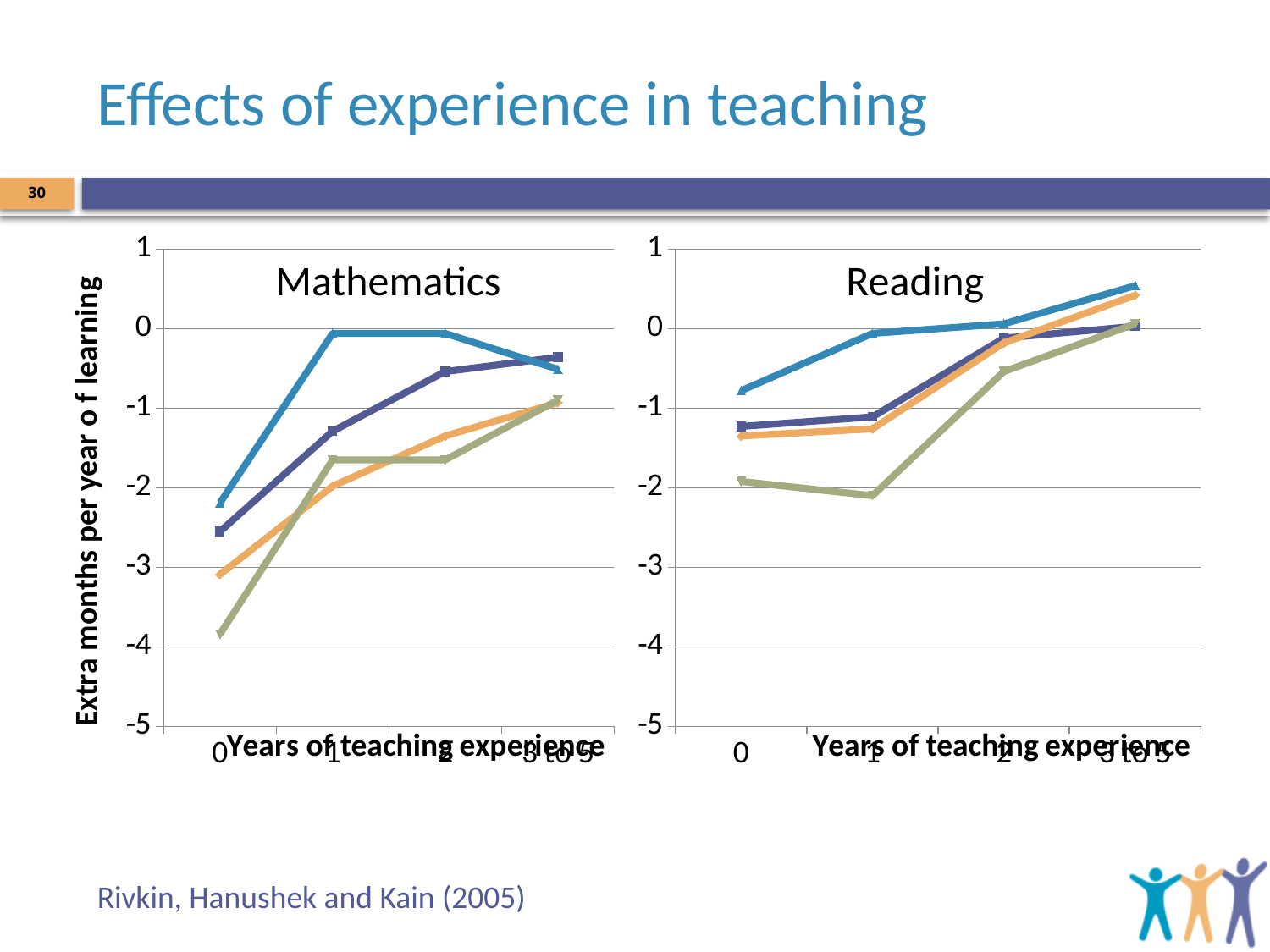
How many lines are plotted on the Mathematics chart? 4 In the Mathematics chart, at 0 years of experience, which line is higher: the light blue line or the green line? the light blue line In the Mathematics chart, do the values generally rise or fall as years of teaching experience increase? rise What kind of chart is the Mathematics chart? line chart In the Mathematics chart, is the value of the green line at 0 years greater or less than -3? less In the Reading chart, is the value of the green line at 1 year greater or less than -1? less What is the y-axis label of the Mathematics chart? Extra months per year of learning How many categories are shown on the x axis of the Reading chart? 4 In the Reading chart, is the value of the light blue line at 0 years greater or less than -1? greater In the Mathematics chart, at which years-of-experience category does the green line reach its lowest value? 0 In the Reading chart, do the values generally rise or fall as years of teaching experience increase? rise